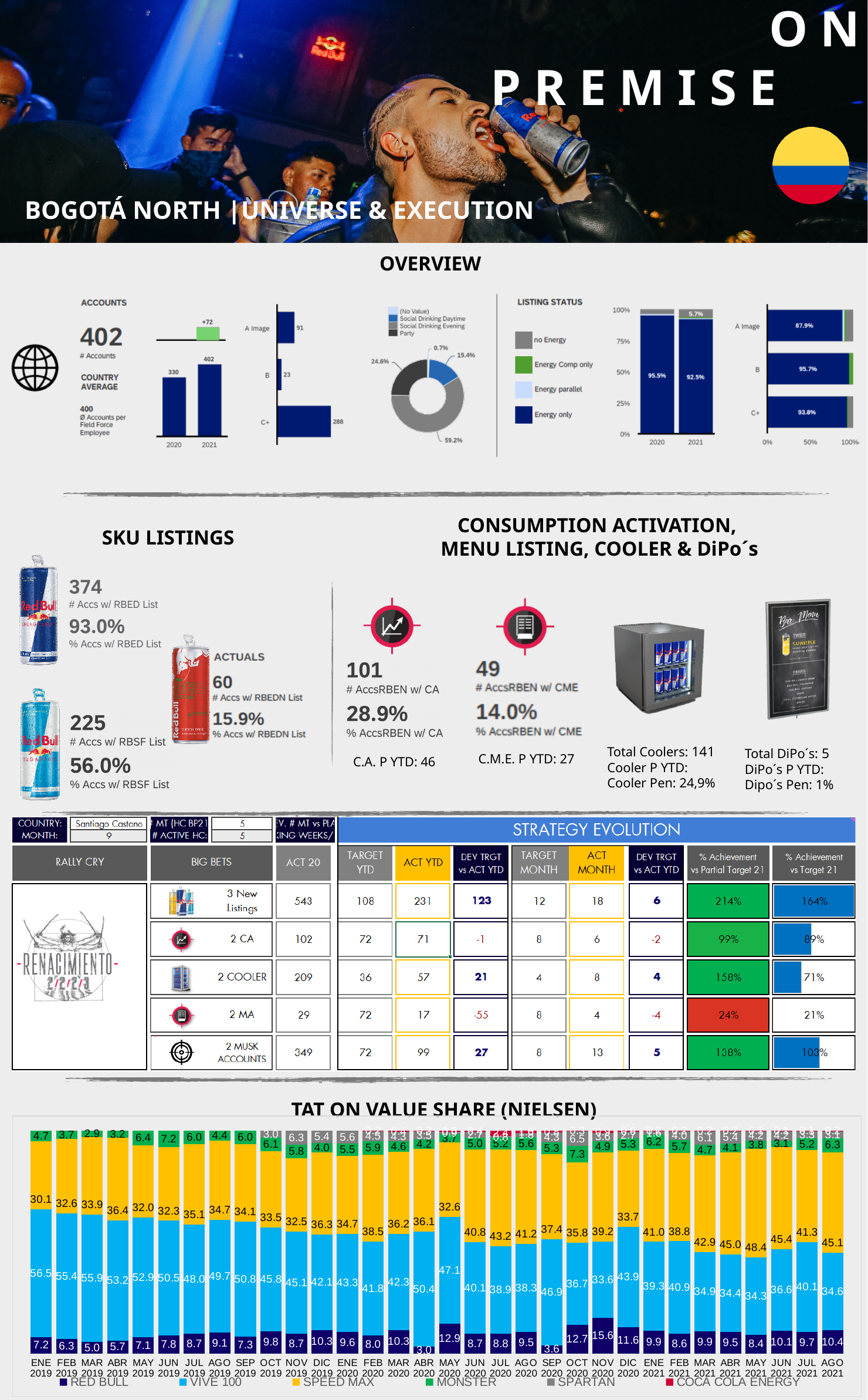
In the Listing Status horizontal bar chart by A Image, B and C+, which category has the highest Energy only share? B In the Accounts bar chart in the Overview section, what is the value for 2021? 402 How many series does the legend of the TAT ON VALUE SHARE (NIELSEN) chart list? 6 In the horizontal bar chart of A Image, B and C+ in the Overview section, what is the value for B? 23 In the TAT ON VALUE SHARE (NIELSEN) chart, what is the RED BULL value for AGO 2021? 10.4 In the horizontal bar chart of A Image, B and C+ in the Overview section, which category has the highest value? C+ In the donut chart in the Overview section, which segment is the smallest? (No Value) In the donut chart in the Overview section, what share does Social Drinking Evening have? 59.2% In the Listing Status stacked bar chart, what is the Energy only share for 2020? 95.5% In the TAT ON VALUE SHARE (NIELSEN) chart, in which month is the RED BULL value highest? NOV 2020 In the Accounts bar chart in the Overview section, what is the difference between the 2021 and 2020 values? 72 How many months are shown on the x axis of the TAT ON VALUE SHARE (NIELSEN) chart? 32